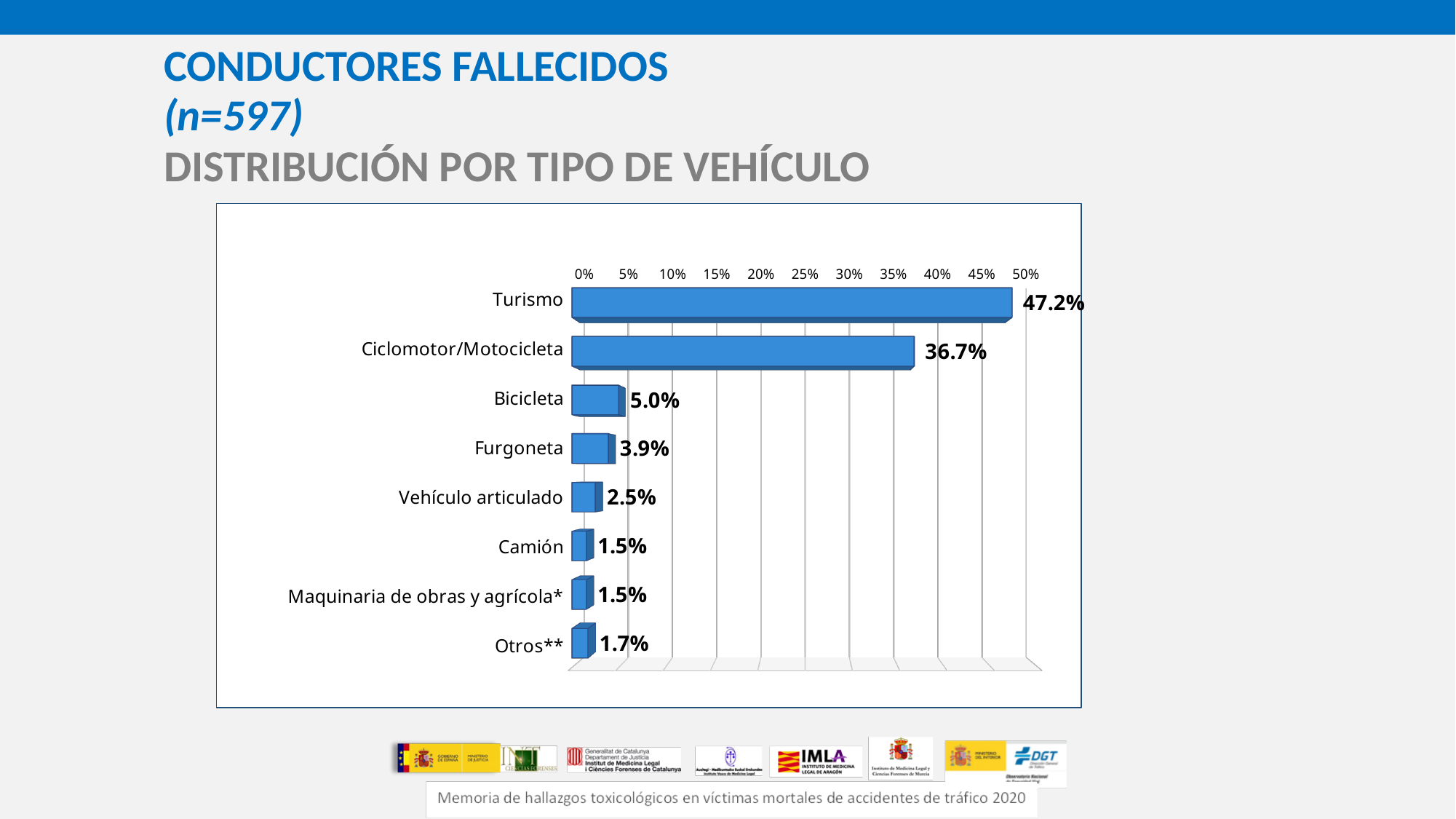
What is the value for Turismo? 47.2% Is the value for Ciclomotor/Motocicleta greater or less than 35%? greater Which vehicle type has the highest value? Turismo What is the difference between the values for Bicicleta and Furgoneta? 1.1% Which is larger, the value for Vehículo articulado or the value for Camión? Vehículo articulado What is the value for Furgoneta? 3.9% How many vehicle categories are shown in the chart? 8 What is the value for Ciclomotor/Motocicleta? 36.7% What is the value for Otros**? 1.7% What is the sample size (n) stated in the slide title? 597 What is the difference between the values for Turismo and Ciclomotor/Motocicleta? 10.5% What kind of chart is shown on the slide? Bar chart